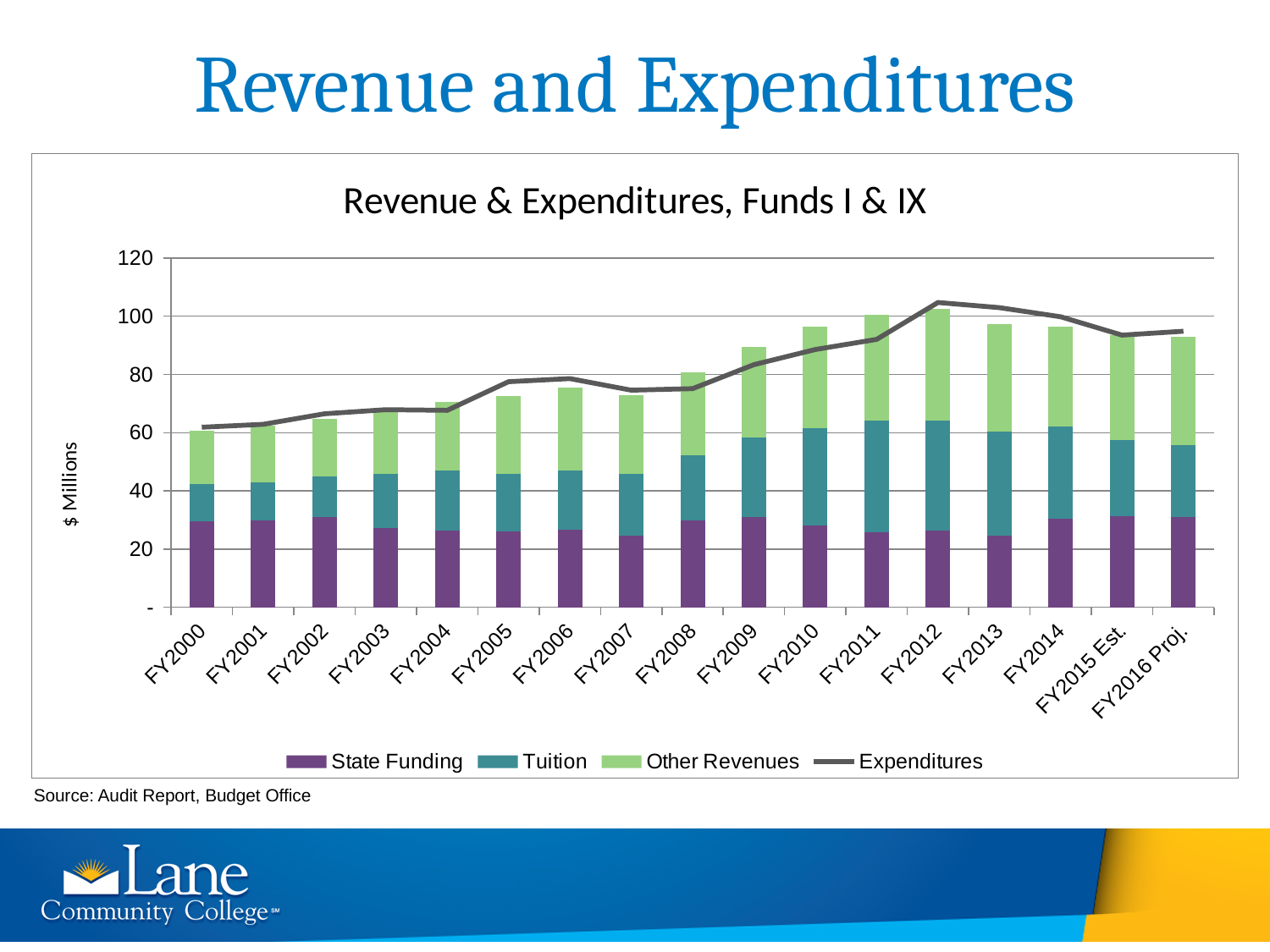
What is the label on the vertical axis? $ Millions Which is larger, the total revenue bar for FY2009 or for FY2005? FY2009 How many fiscal-year categories are shown on the x axis? 17 Do total revenues generally rise or fall from FY2000 to FY2012? rise Which fiscal year has the shortest stacked revenue bar? FY2000 What kind of chart is shown on the slide? Stacked bar chart with a line Which fiscal year has the tallest stacked revenue bar? FY2012 Is the total revenue bar for FY2012 greater or less than 100? greater Is the Expenditures line value for FY2012 greater or less than 100? greater How many series does the legend list? 4 Is the total revenue bar for FY2000 greater or less than 80? less